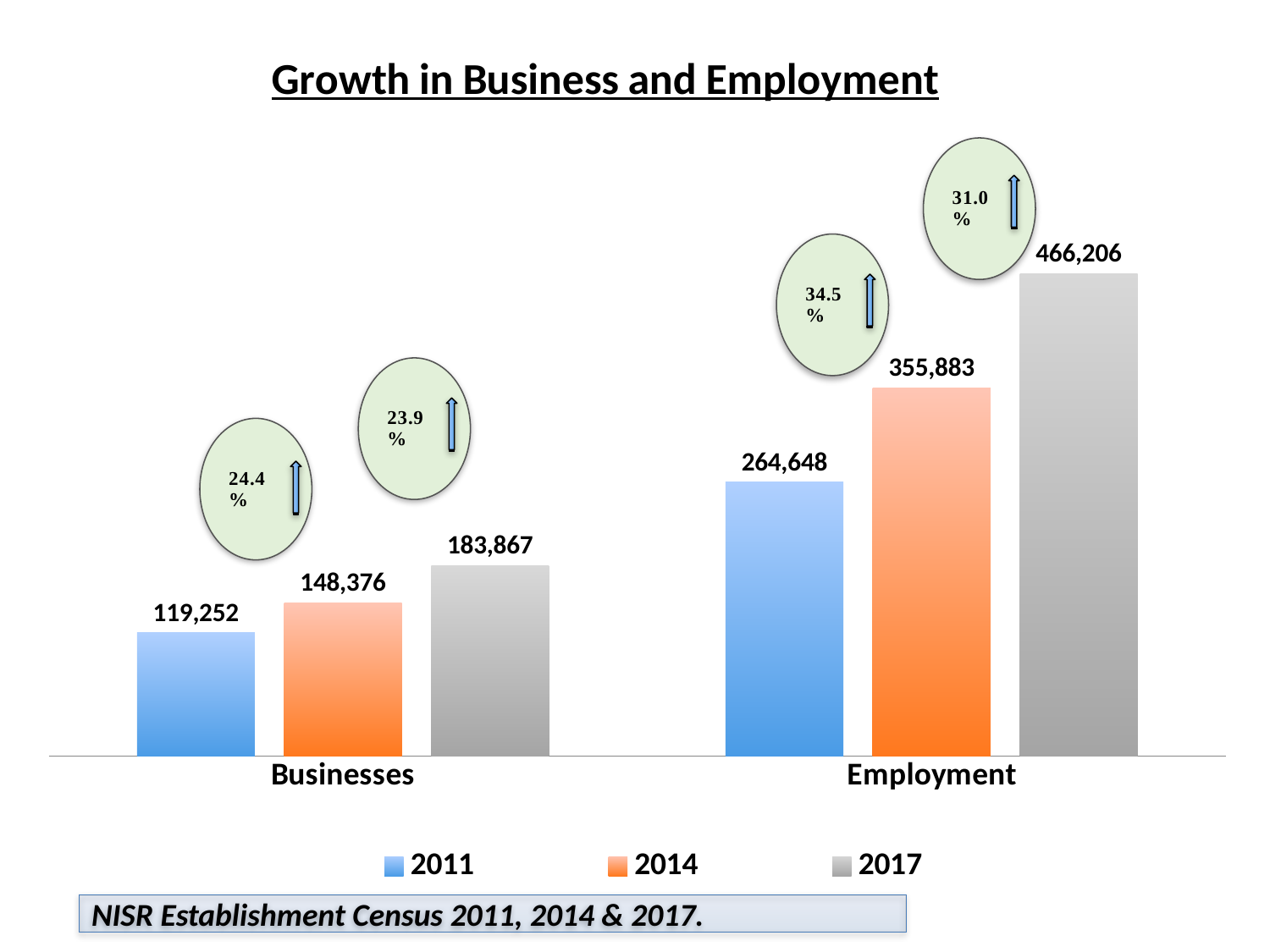
How many series does the legend list? 3 Which is larger, Employment in 2011 or Businesses in 2017? Employment in 2011 What is the value for Employment in 2017? 466,206 What is the value for Businesses in 2017? 183,867 What is the title of the chart? Growth in Business and Employment What is the difference between the Businesses values for 2017 and 2014? 35,491 What kind of chart is shown on the slide? Bar chart Which year has the lowest Businesses value? 2011 What is the value for Businesses in 2011? 119,252 Which year has the highest Employment value? 2017 What is the value for Employment in 2014? 355,883 What is the difference between the Employment values for 2014 and 2011? 91,235